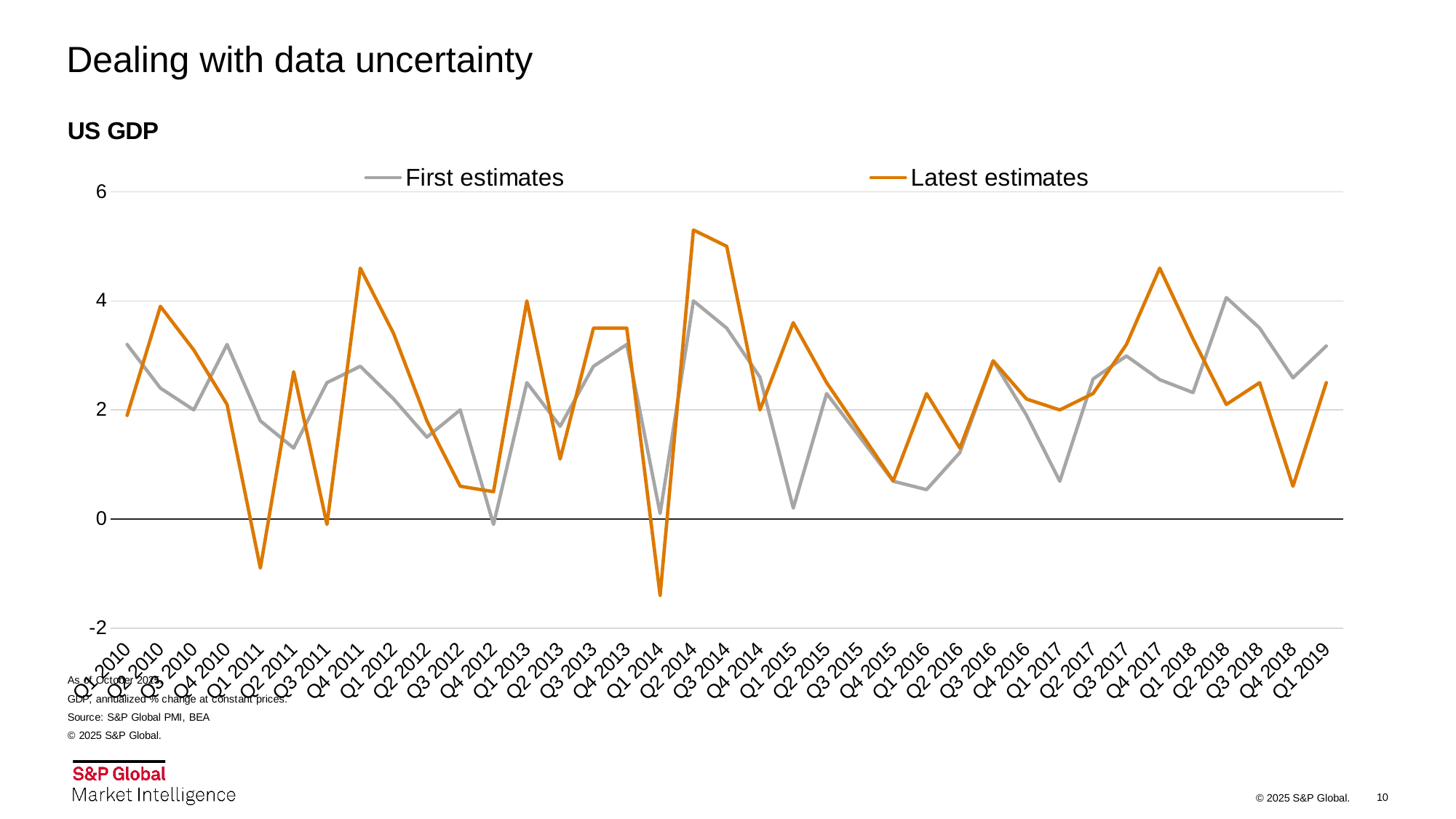
Is the Latest estimates value for Q1 2014 greater or less than 0? less Is the Latest estimates value for Q2 2014 greater or less than 4? greater What kind of chart is shown on the slide? Line chart What colour is the Latest estimates line? Orange How many series does the legend list? 2 In which quarter does the Latest estimates series reach its lowest value? Q1 2014 How many quarters are plotted along the x axis? 37 For Q4 2017, which series has the larger value, First estimates or Latest estimates? Latest estimates Is the First estimates value for Q1 2010 greater or less than 2? greater For Q1 2011, which series has the larger value, First estimates or Latest estimates? First estimates Does the Latest estimates series rise or fall from Q1 2014 to Q2 2014? Rise In which quarter does the Latest estimates series reach its highest value? Q2 2014